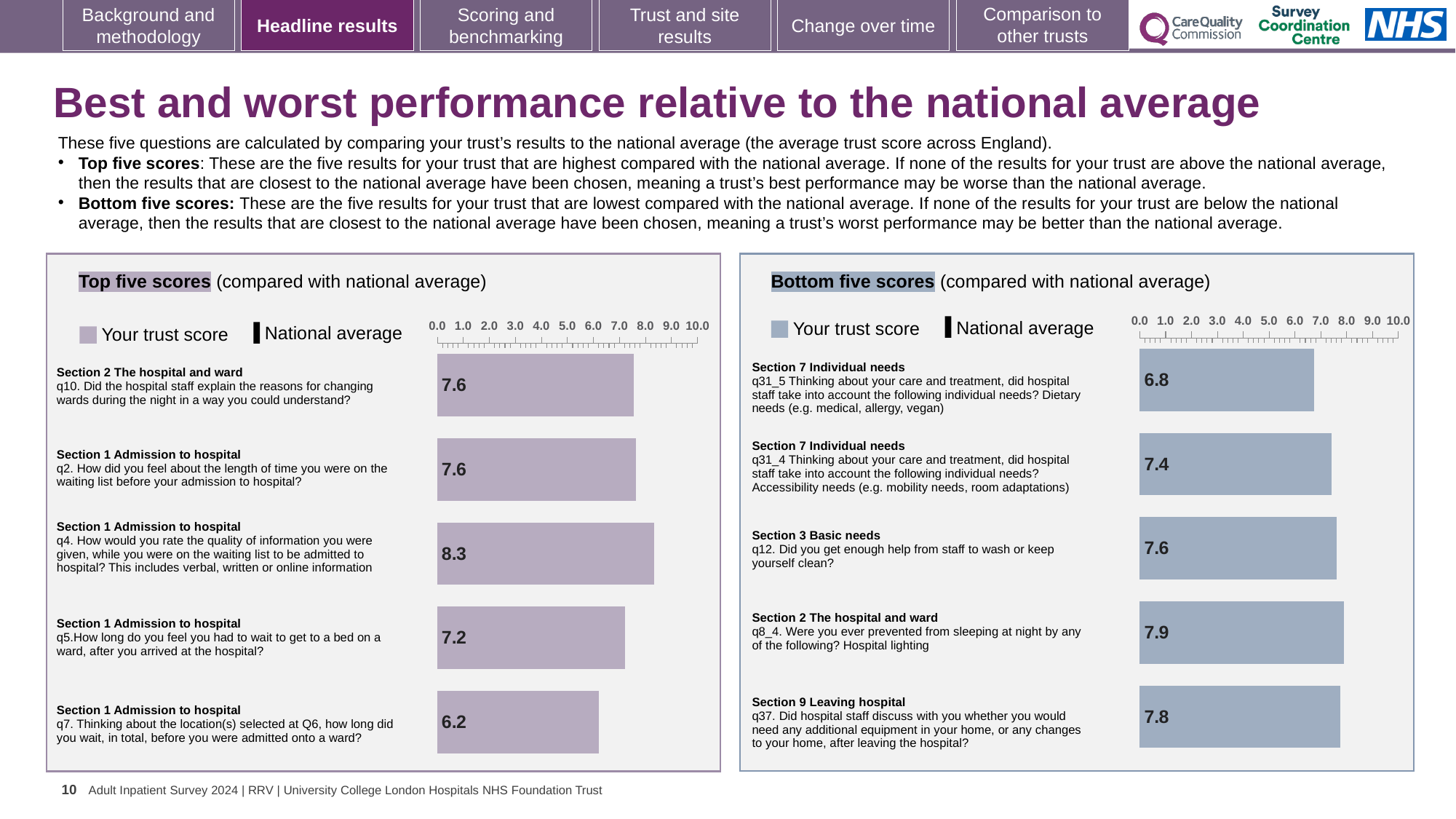
In the Top five scores chart, which question has the highest trust score? q4 (8.3) In the Bottom five scores chart, which question has the lowest trust score? q31_5 (6.8) In the Top five scores chart, what is the trust score for q7 (how long you waited before being admitted onto a ward)? 6.2 In the Bottom five scores chart, what is the trust score for q31_5 (dietary needs)? 6.8 How many bars are plotted in the Top five scores chart? 5 In the Bottom five scores chart, which is larger: the trust score for q12 or for q31_4? q12 (7.6) In the Top five scores chart, what is the difference between the trust scores for q4 and q7? 2.1 In the Bottom five scores chart, what is the trust score for q8_4 (hospital lighting)? 7.9 In the Top five scores chart, which question has the lowest trust score? q7 (6.2) In the Bottom five scores chart, what is the difference between the trust scores for q8_4 and q31_5? 1.1 What type of chart is used for the Bottom five scores? Bar chart In the Top five scores chart, what is the trust score for q4 (quality of information given while on the waiting list)? 8.3